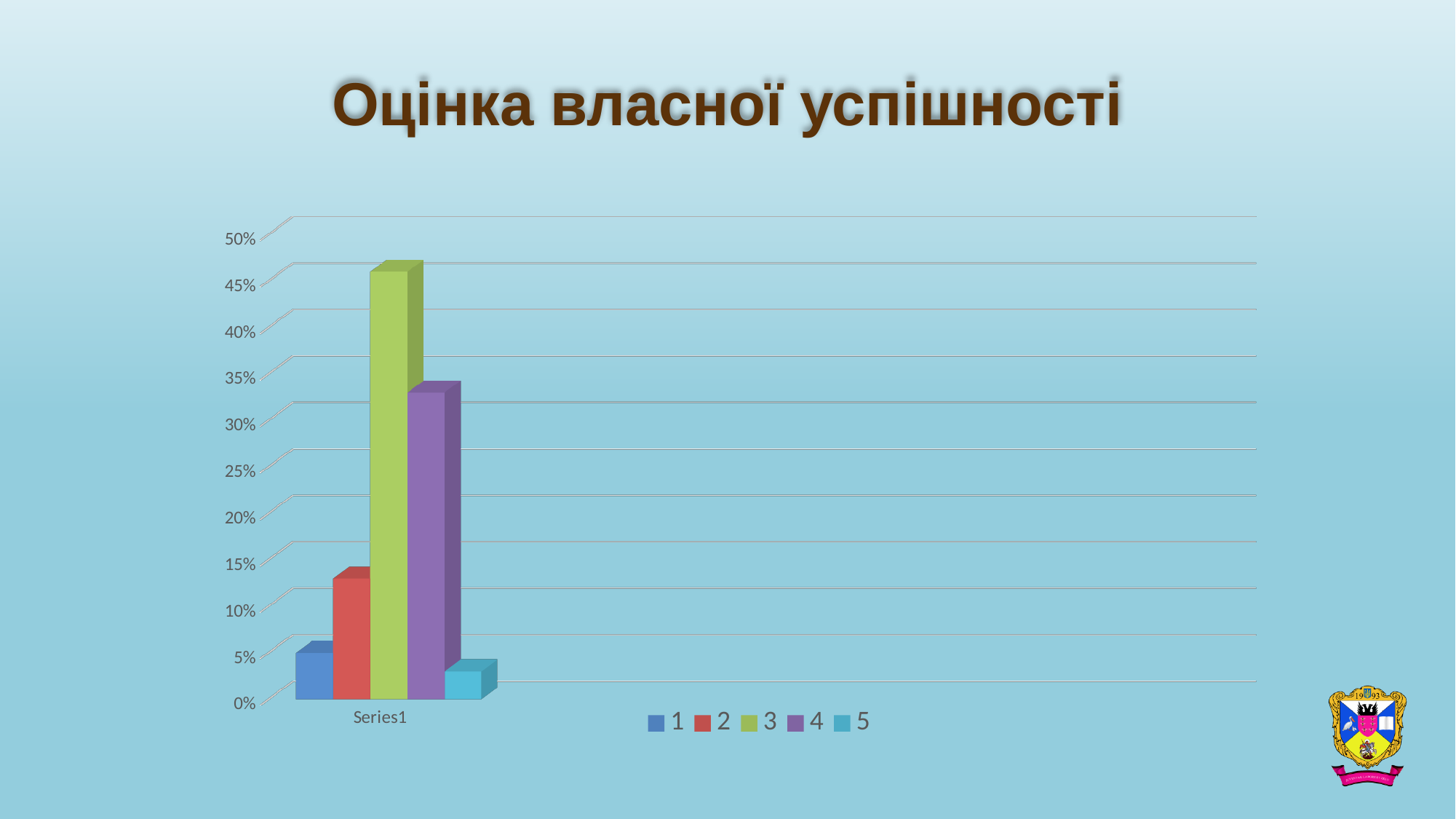
Is the value for series 3 greater or less than 40%? greater What is the title of the chart? Оцінка власної успішності What type of chart is shown on the slide? bar chart Is the value for series 4 greater or less than 35%? less Which is larger, the value for series 3 or series 4? series 3 Is the value for series 1 greater or less than 10%? less Which series has the highest value? 3 How many series does the legend list? 5 How many categories are shown on the x axis? 1 Which is larger, the value for series 2 or series 4? series 4